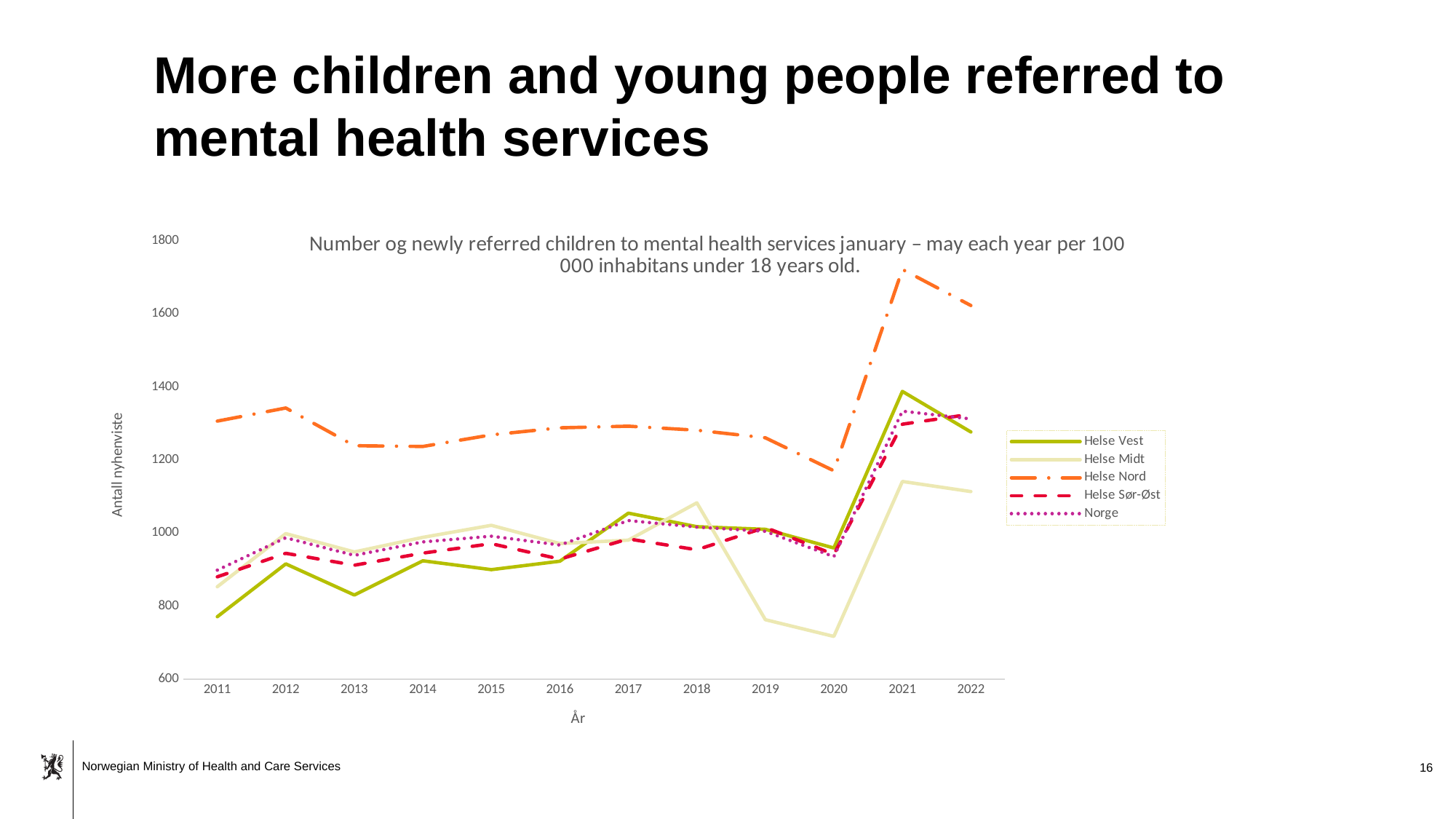
Is the value for Helse Midt in 2020 greater or less than 800? less Which series has the highest value in 2021? Helse Nord Is the value for Helse Vest in 2011 greater or less than 800? less Which series has the lowest value in 2020? Helse Midt In 2022, which is larger: Helse Nord or Helse Midt? Helse Nord Does the Helse Nord line rise or fall from 2020 to 2021? rise In which year does Helse Vest reach its highest value? 2021 What kind of chart is shown on the slide? line chart What is the label on the y axis of the chart? Antall nyhenviste Is the value for Helse Nord in 2021 greater or less than 1600? greater How many years are shown on the x axis? 12 How many series does the legend list? 5